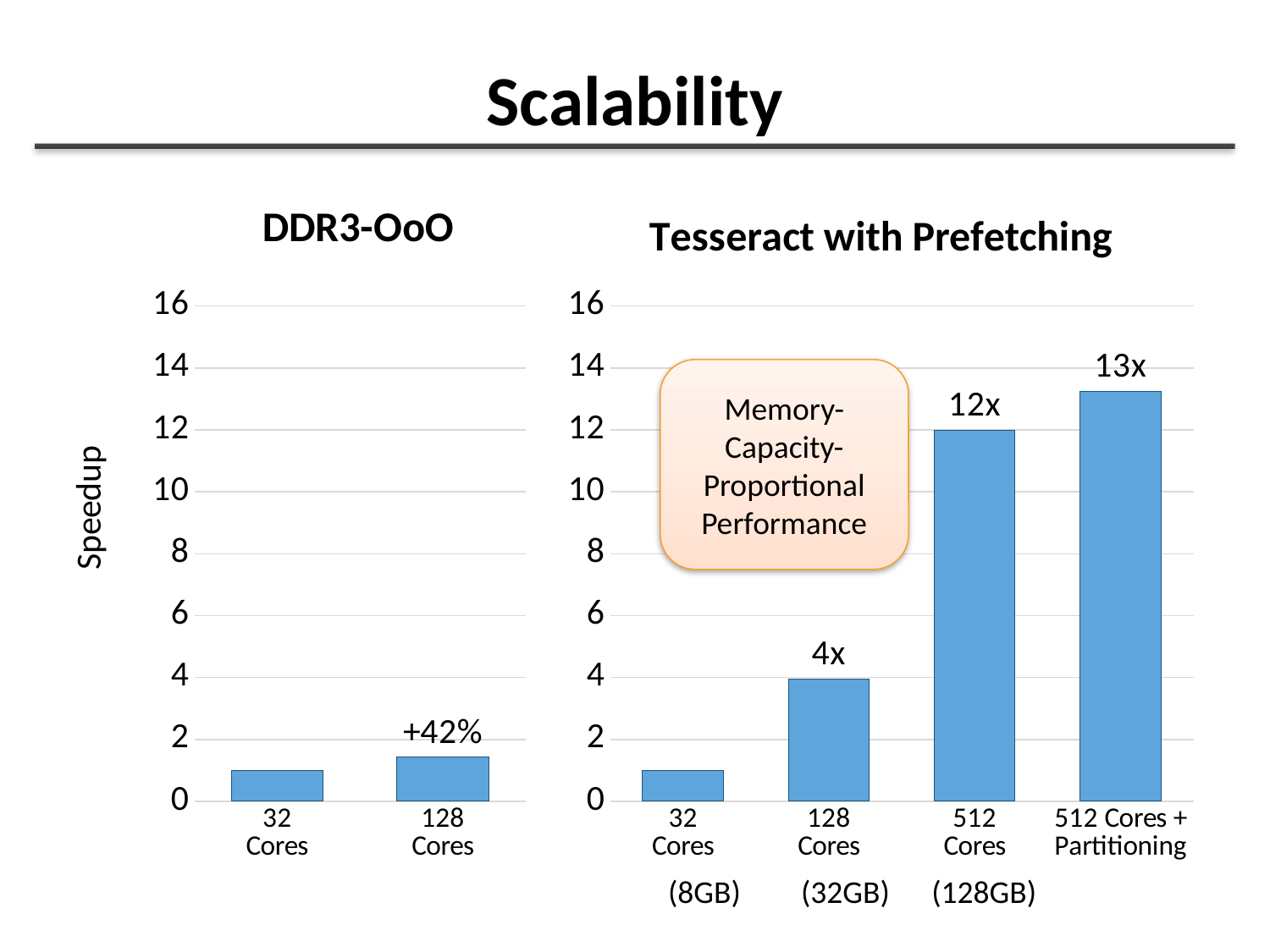
How many bars does the Tesseract with Prefetching chart have? 4 In the Tesseract with Prefetching chart, do the speedup values rise or fall from left to right? rise In the Tesseract with Prefetching chart, is the speedup for 512 Cores greater or less than 10? greater What is the y-axis title of the DDR3-OoO chart? Speedup In the Tesseract with Prefetching chart, what label is printed above the 512 Cores bar? 12x In the DDR3-OoO chart, what label is printed above the 128 Cores bar? +42% What kind of chart is the DDR3-OoO chart? bar chart In the Tesseract with Prefetching chart, which category has the highest speedup? 512 Cores + Partitioning In the Tesseract with Prefetching chart, which category has the lowest speedup? 32 Cores How many bars does the DDR3-OoO chart have? 2 In the Tesseract with Prefetching chart, what label is printed above the 128 Cores bar? 4x In the DDR3-OoO chart, is the speedup for 128 Cores greater or less than 2? less